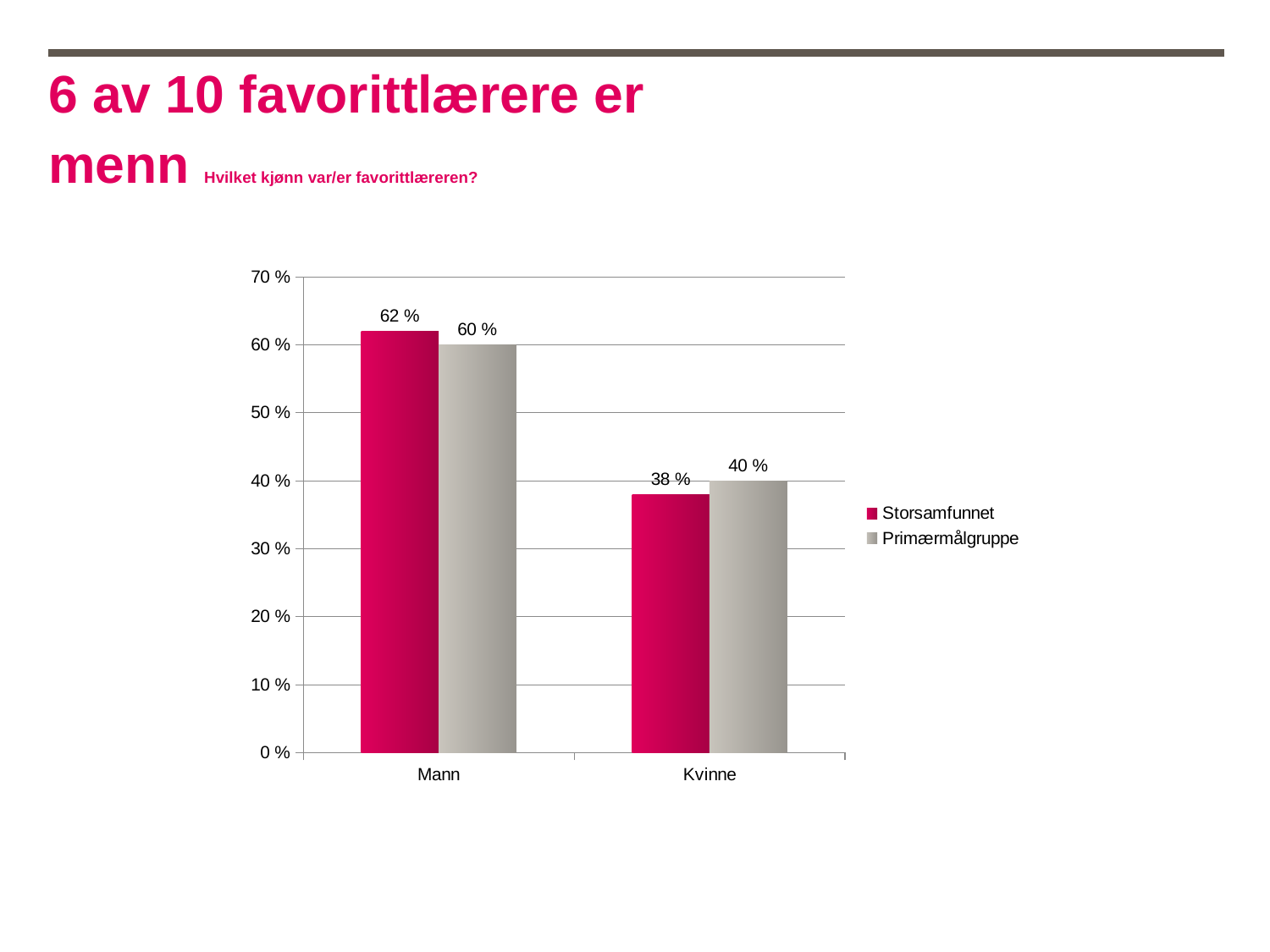
How many categories are shown on the x axis? 2 Which category has the lowest value in the Primærmålgruppe series? Kvinne What is the difference between the Storsamfunnet values for Mann and Kvinne? 24 % What is the value for Mann in the Storsamfunnet series? 62 % Which is larger for Mann: Storsamfunnet or Primærmålgruppe? Storsamfunnet What is the value for Kvinne in the Primærmålgruppe series? 40 % Which category has the highest value in the Storsamfunnet series? Mann How many series does the legend list? 2 What kind of chart is shown on the slide? Bar chart What is the difference between the Storsamfunnet and Primærmålgruppe values for Kvinne? 2 % What is the value for Kvinne in the Storsamfunnet series? 38 % What is the value for Mann in the Primærmålgruppe series? 60 %